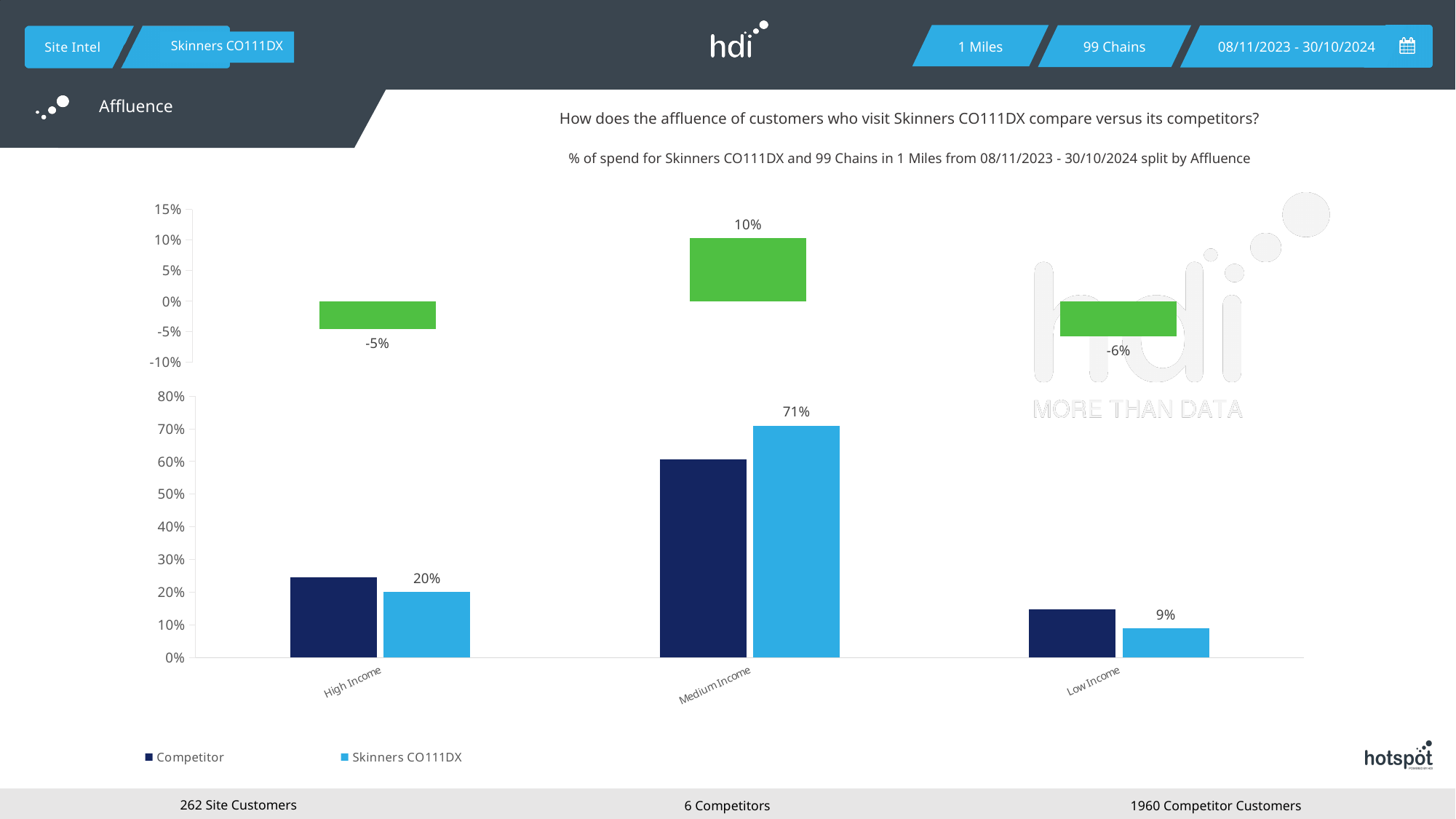
In the bottom chart, what is the value for Skinners CO111DX in the Medium Income category? 71% In the top chart, which category has the highest value? Medium Income How many series does the legend of the bottom chart list? 2 In the bottom chart, which category has the highest value for Skinners CO111DX? Medium Income In the top chart, what is the value shown for Low Income? -6% How many categories are shown on the x axis of the bottom chart? 3 In the top chart, what is the value shown for Medium Income? 10% In the top chart, which category has the lowest value? Low Income In the bottom chart, for High Income, which is larger: the Competitor bar or the Skinners CO111DX bar? Competitor In the bottom chart, is the Competitor value for Medium Income greater or less than 50%? greater In the bottom chart, what is the difference between the Skinners CO111DX values for Medium Income and High Income? 51 percentage points In the bottom chart, what is the value for Skinners CO111DX in the Low Income category? 9%